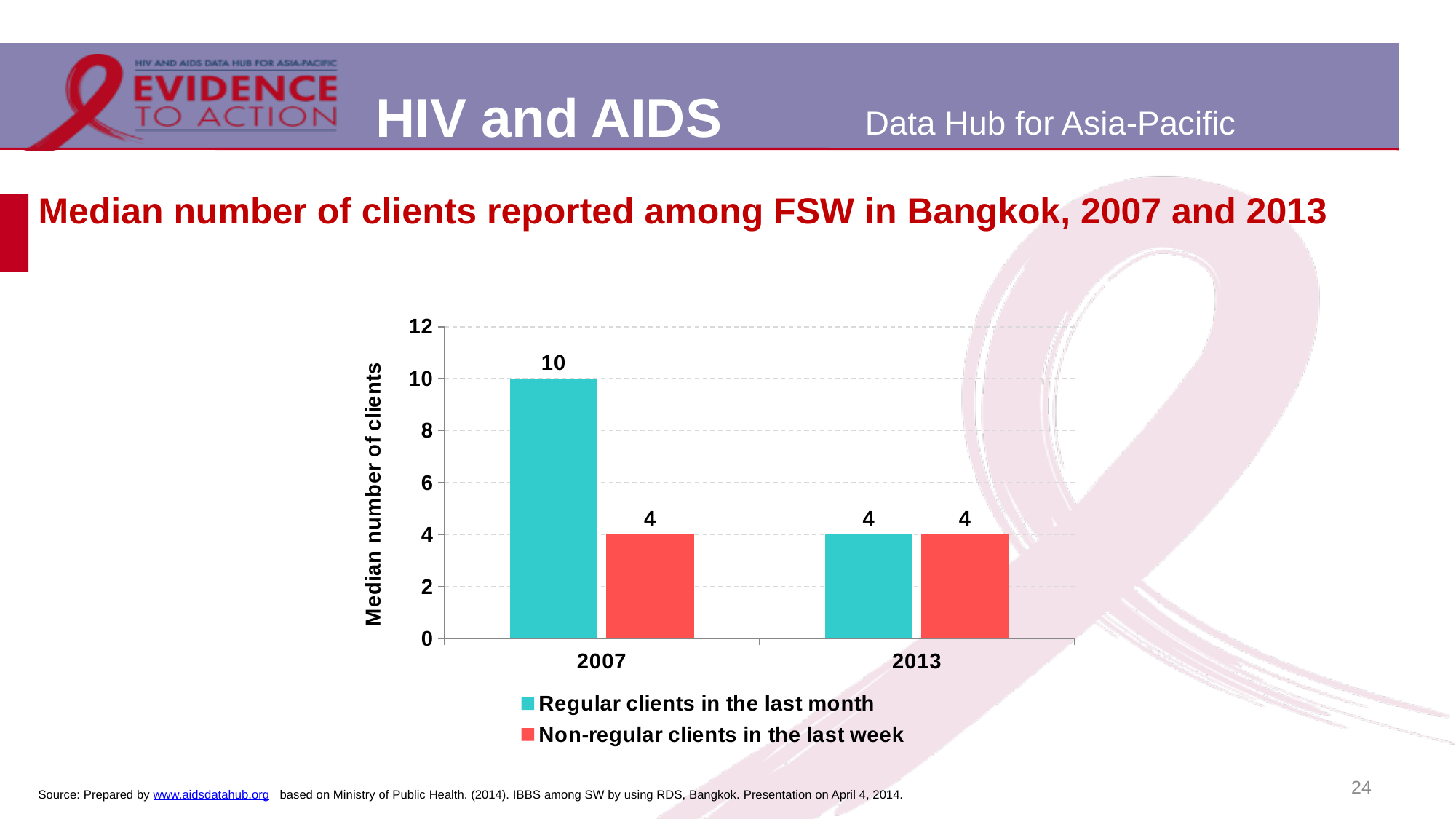
How many years are shown on the x axis? 2 What is the median number of non-regular clients in the last week reported in 2013? 4 Which year has the highest value for regular clients in the last month? 2007 What is the median number of non-regular clients in the last week reported in 2007? 4 What is the difference between regular clients in the last month in 2007 and in 2013? 6 What kind of chart is shown on the slide? bar chart In 2007, which is larger: regular clients in the last month or non-regular clients in the last week? Regular clients in the last month What is the label of the y axis? Median number of clients Does the value for regular clients in the last month in 2007 rise or fall from 2007 to 2013? fall What is the median number of regular clients in the last month reported in 2007? 10 How many series does the legend list? 2 What is the median number of regular clients in the last month reported in 2013? 4